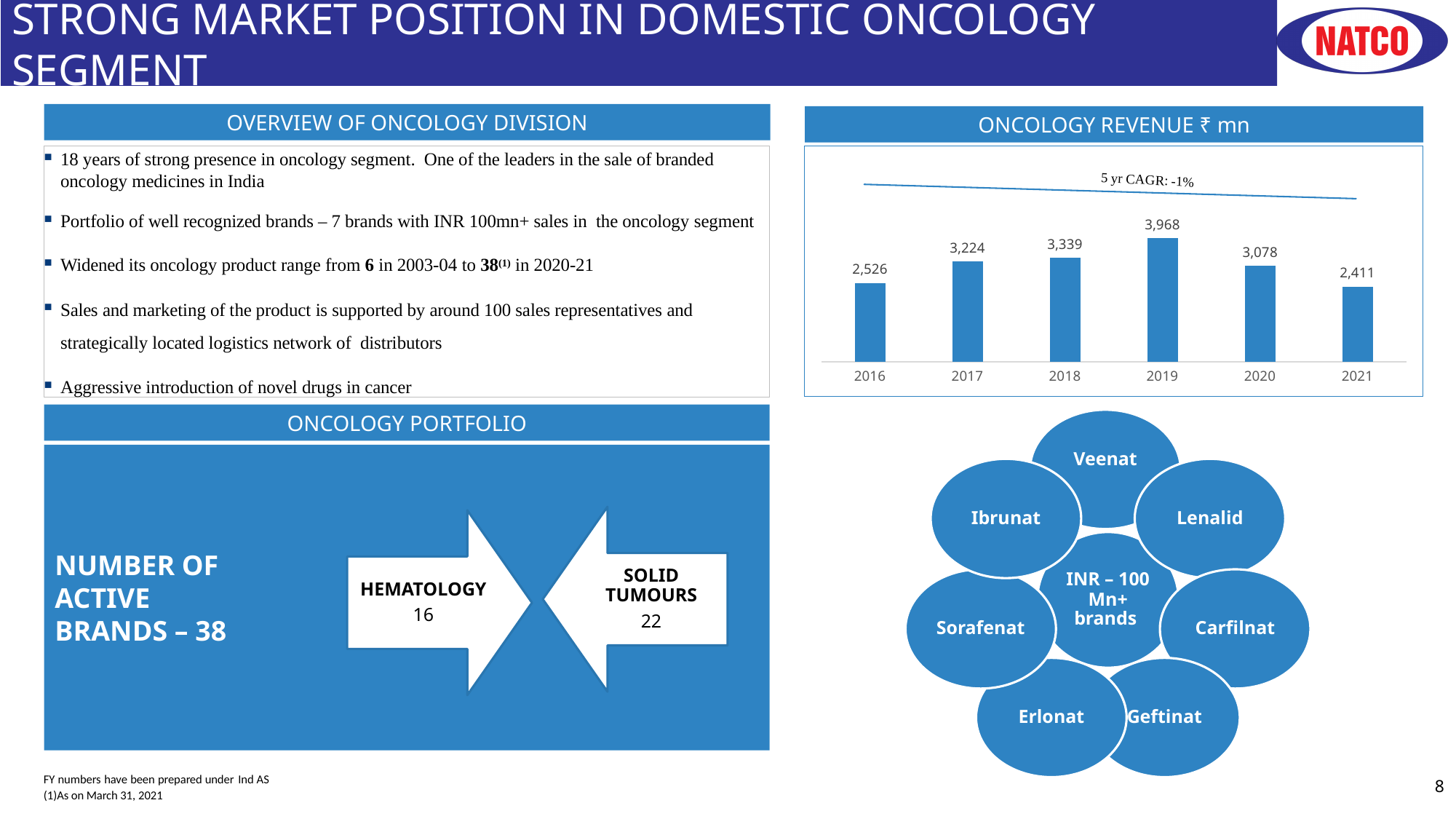
What is the oncology revenue for 2019? 3,968 What kind of chart is the oncology revenue chart? bar chart What is the difference in oncology revenue between 2017 and 2016? 698 Which year has higher oncology revenue, 2018 or 2020? 2018 Which year has the lowest oncology revenue? 2021 What is the oncology revenue for 2021? 2,411 Does oncology revenue rise or fall from 2019 to 2021? fall What is the oncology revenue for 2016? 2,526 What is the difference in oncology revenue between 2019 and 2020? 890 What 5-year CAGR is shown on the oncology revenue chart? -1% How many years are shown in the oncology revenue chart? 6 Which year has the highest oncology revenue? 2019